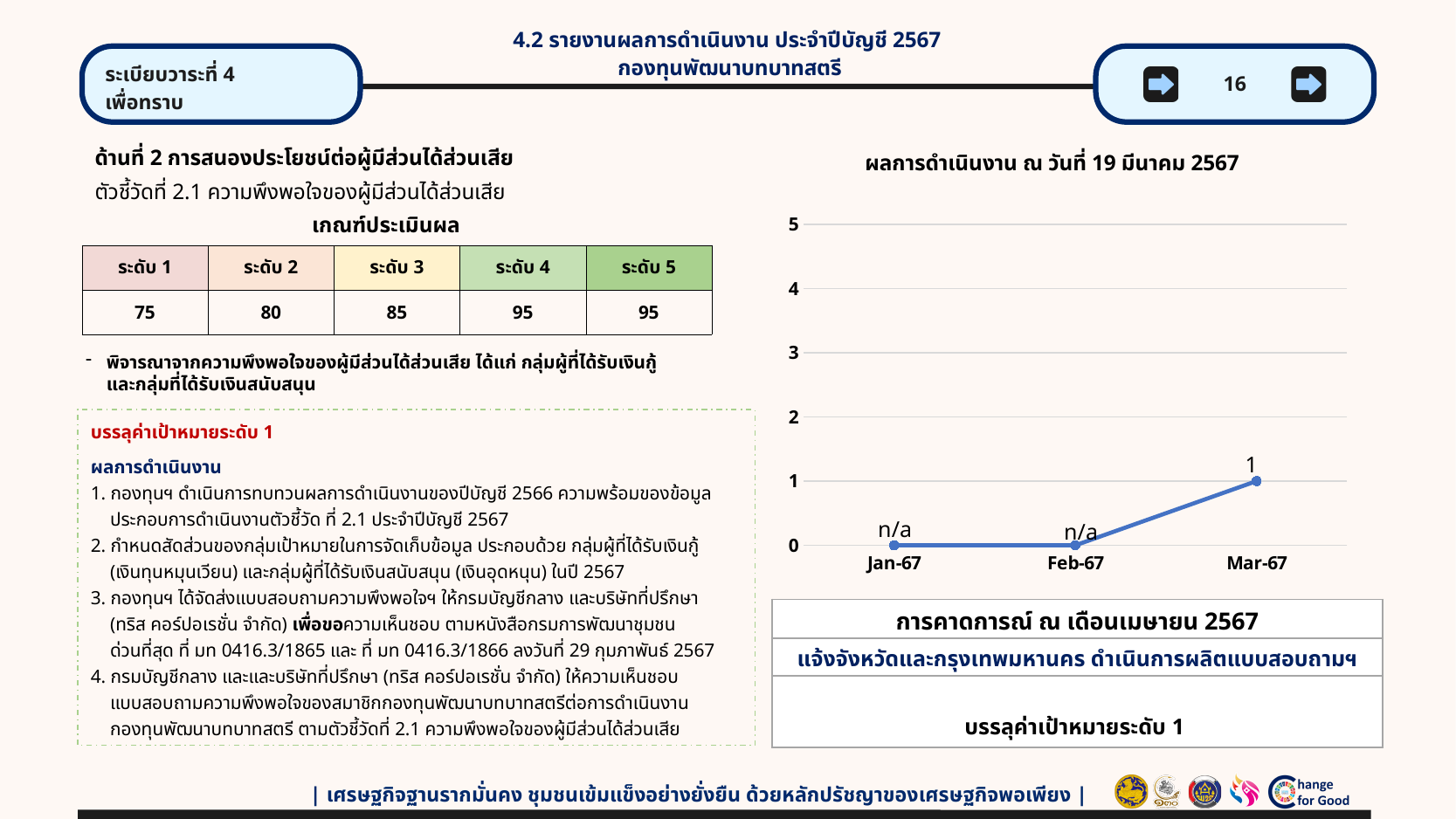
Is the value for Mar-67 greater or less than 2? less What is the title of the chart on the right side of the slide? ผลการดำเนินงาน ณ วันที่ 19 มีนาคม 2567 What is the highest value shown on the y axis of the chart? 5 Which is larger in the chart, the value for Feb-67 or the value for Mar-67? Mar-67 What is the label of the last category on the x axis of the chart? Mar-67 What is the data label shown for Feb-67 in the chart? n/a What is the data label shown for Mar-67 in the chart? 1 Which month has the highest plotted value in the chart? Mar-67 Does the line rise or fall between Feb-67 and Mar-67? rise What is the data label shown for Jan-67 in the chart? n/a What kind of chart is shown on the right side of the slide? line chart How many points are plotted along the x axis of the chart? 3